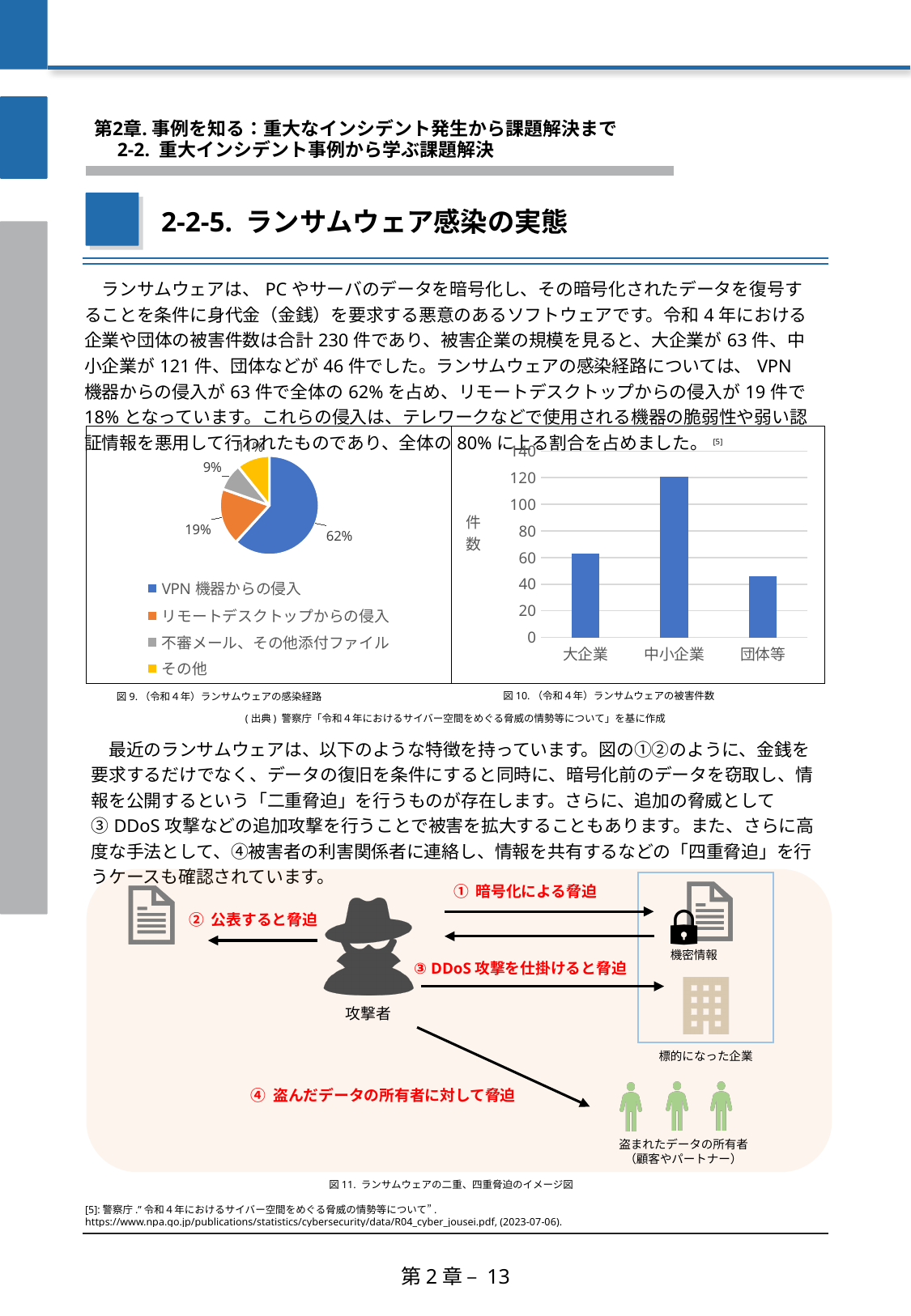
In the bar chart 図10, which category has the lowest number of cases? 団体等 What kind of chart is 図9 (ランサムウェアの感染経路), on the left? pie chart In the pie chart 図9, what percentage is shown for リモートデスクトップからの侵入? 19% In the pie chart 図9, which infection route has the largest share? VPN 機器からの侵入 What kind of chart is 図10 (ランサムウェアの被害件数), on the right? bar chart In the bar chart 図10, how many categories are shown on the x axis? 3 In the bar chart 図10, which category has the highest number of cases? 中小企業 In the pie chart 図9, what percentage is shown for VPN 機器からの侵入? 62% In the pie chart 図9, what percentage is shown for 不審メール、その他添付ファイル? 9% In the bar chart 図10, is the value for 団体等 greater or less than 60? less In the pie chart 図9, how many entries does the legend list? 4 In the bar chart 図10, is the value for 中小企業 greater or less than 100? greater